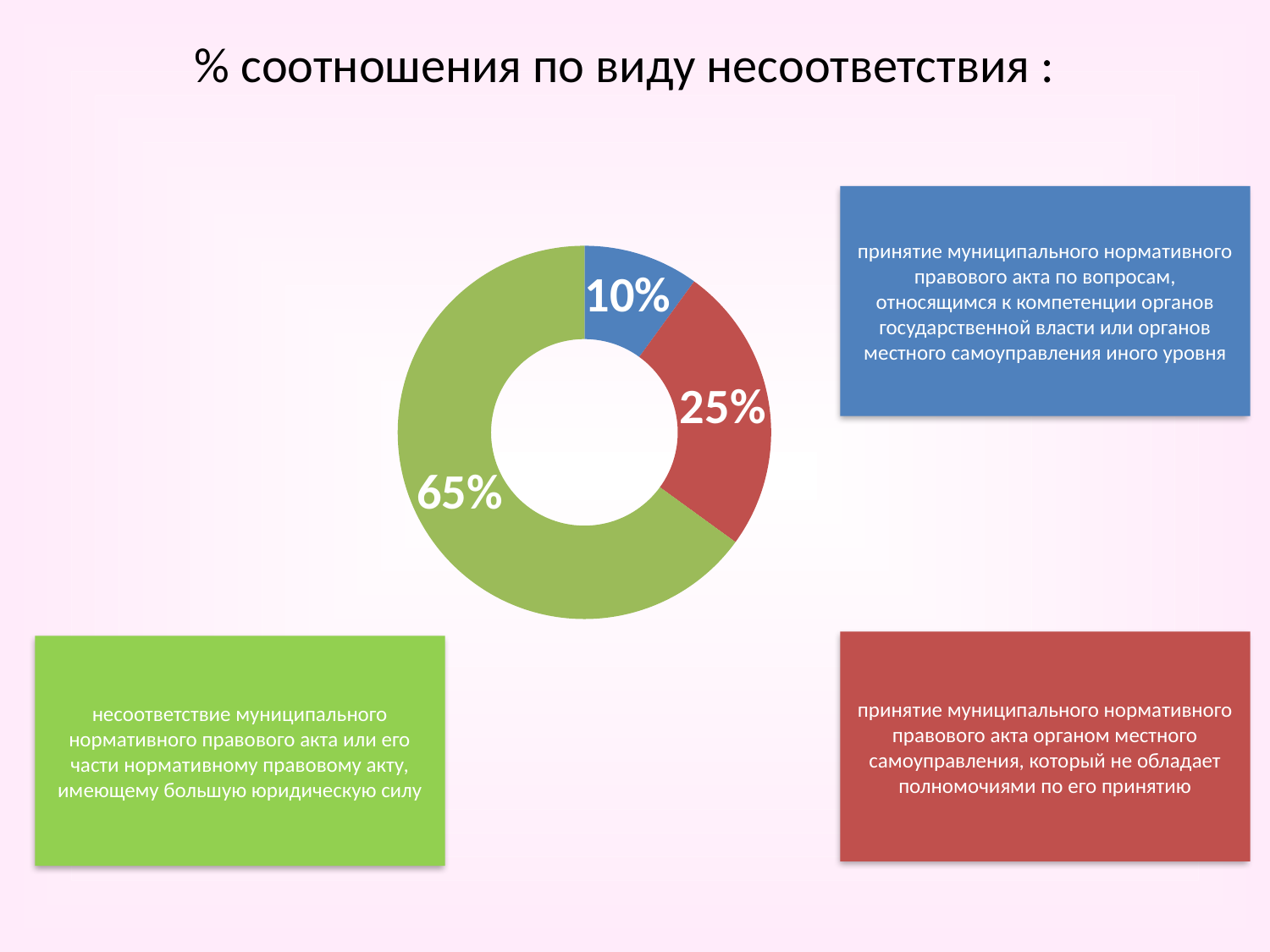
How many slices does the doughnut chart have? 3 What kind of chart is shown on the slide? Doughnut chart Which is larger, the red slice or the blue slice? The red slice What percentage is shown for the green slice of the doughnut chart? 65% What do the three slice percentages add up to? 100% What percentage is shown for the blue slice of the doughnut chart? 10% By how many percentage points does the red slice exceed the blue slice? 15 percentage points By how many percentage points does the green slice exceed the red slice? 40 percentage points Which slice of the doughnut chart is the largest? The green slice (65%) What percentage is shown for the red slice of the doughnut chart? 25% What is the title of the slide? % соотношения по виду несоответствия : Which slice of the doughnut chart is the smallest? The blue slice (10%)